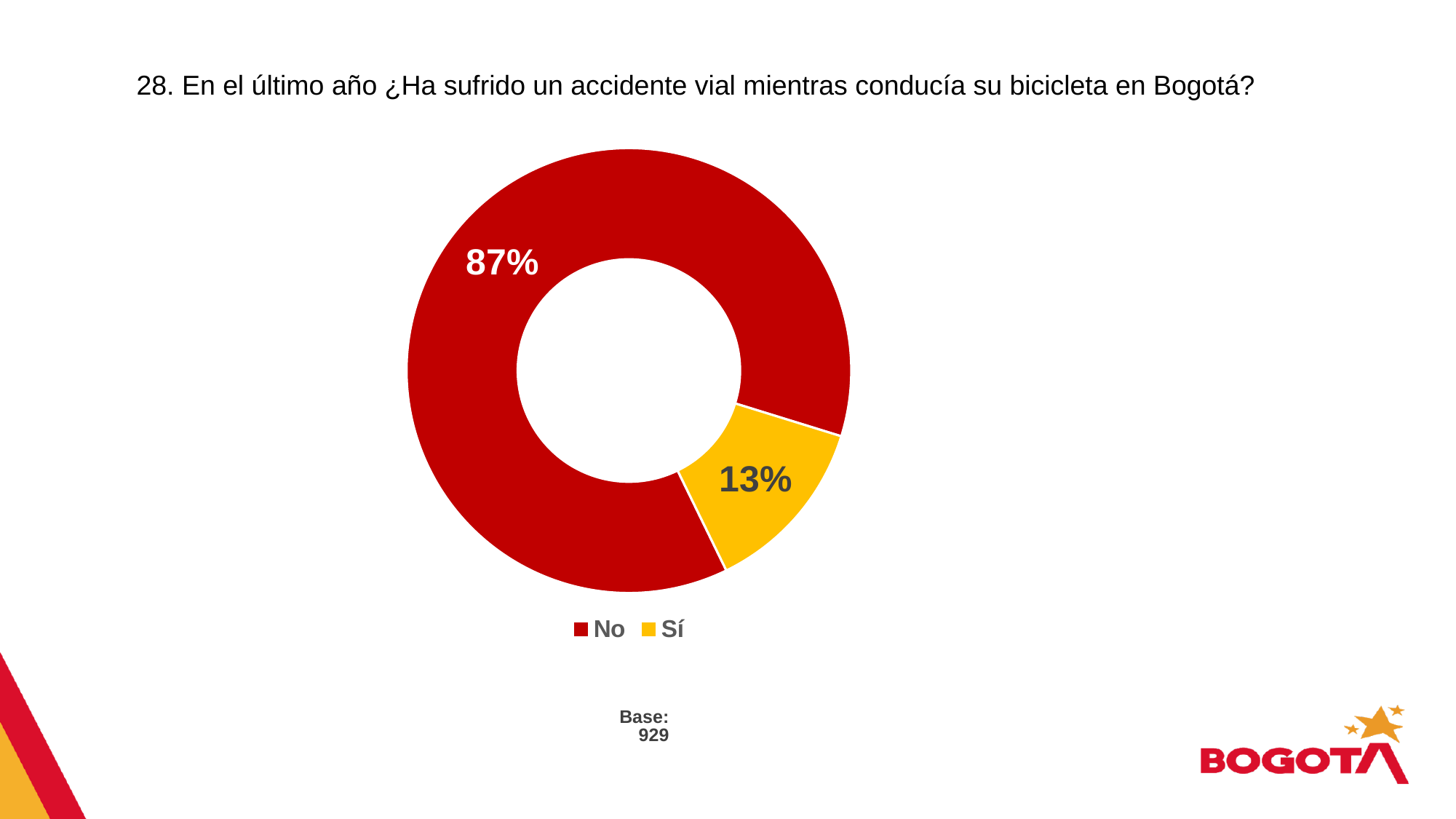
Which category has the smallest share of the chart? Sí How many categories does the chart show? 2 Which category has the largest share of the chart? No What is the base (number of respondents) shown below the chart? 929 Which is larger, the share for "No" or the share for "Sí"? No What share of the chart does the "Sí" slice represent? 13% What is the difference in percentage points between "No" and "Sí"? 74 How many entries does the legend list? 2 What kind of chart is shown on the slide? Doughnut (pie) chart What percentage of respondents answered "Sí"? 13% What colour is the "No" slice? Red What percentage of respondents answered "No"? 87%